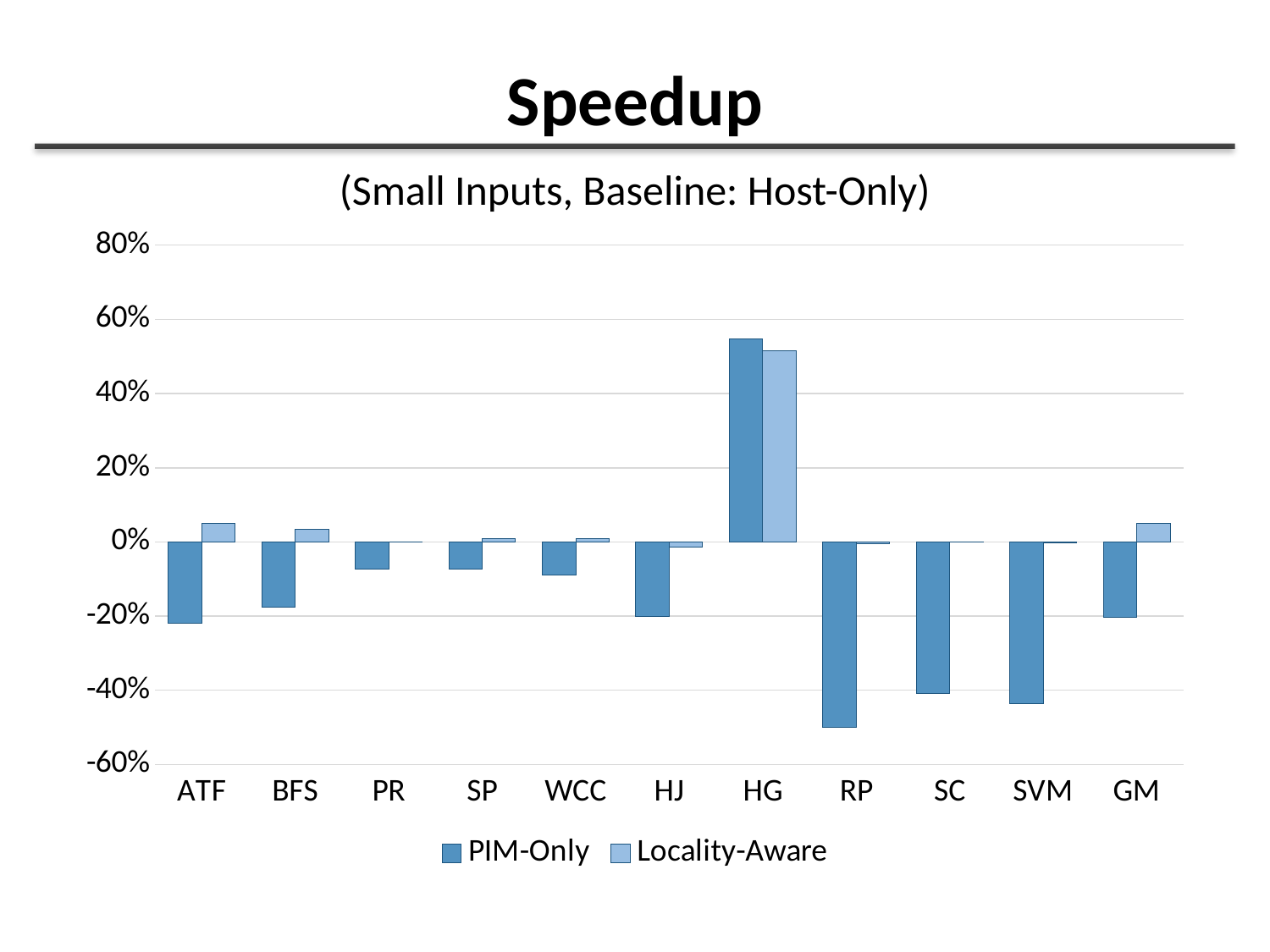
How many categories are shown along the x axis? 11 Which category has the lowest PIM-Only value? RP Is the PIM-Only value for HG greater or less than 40%? greater What subtitle appears above the chart? (Small Inputs, Baseline: Host-Only) Which is larger, the PIM-Only value for BFS or the PIM-Only value for SVM? BFS Is the PIM-Only value for ATF greater or less than -20%? less What kind of chart is shown on the slide? bar chart Which is larger, the Locality-Aware value for ATF or the PIM-Only value for ATF? Locality-Aware Is the PIM-Only value for RP greater or less than -40%? less How many series does the legend list? 2 Which category has the highest PIM-Only value? HG Which category has the highest Locality-Aware value? HG